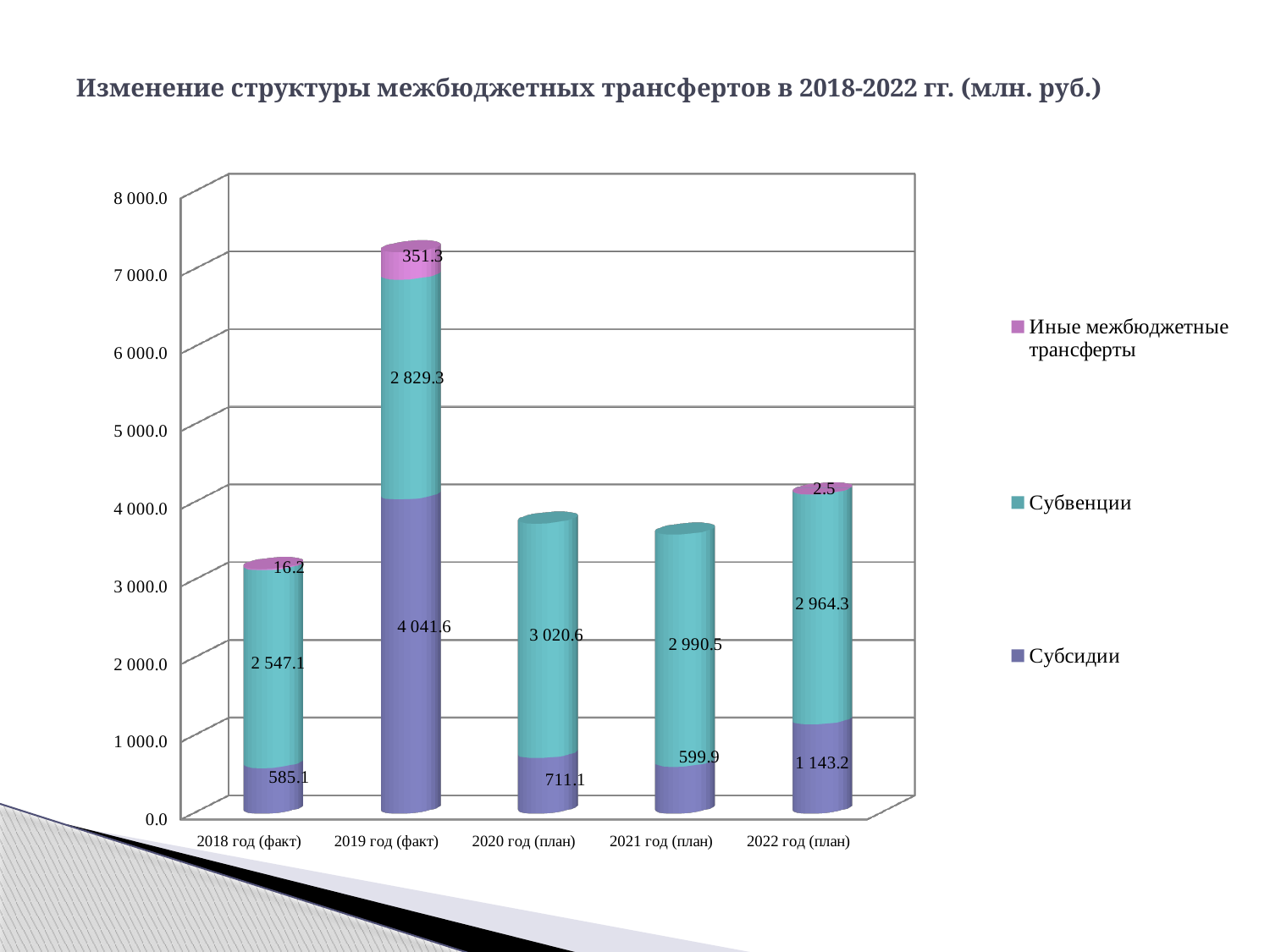
What is the value of Субсидии for 2019 год (факт)? 4 041.6 What is the value of Иные межбюджетные трансферты for 2022 год (план)? 2.5 Which is larger: Субвенции in 2020 год (план) or Субвенции in 2021 год (план)? 2020 год (план) What type of chart is shown on the slide? stacked bar chart Is the total of the stacked bar for 2021 год (план) greater or less than 4 000.0? less How many year categories are shown on the x axis? 5 How many series does the legend list? 3 What is the total of the stacked bar for 2019 год (факт)? 7 222.2 What is the difference between Субсидии in 2022 год (план) and 2021 год (план)? 543.3 Which year has the highest value for Субсидии? 2019 год (факт) What is the value of Субвенции for 2020 год (план)? 3 020.6 Which year has the lowest value for Субсидии? 2018 год (факт)